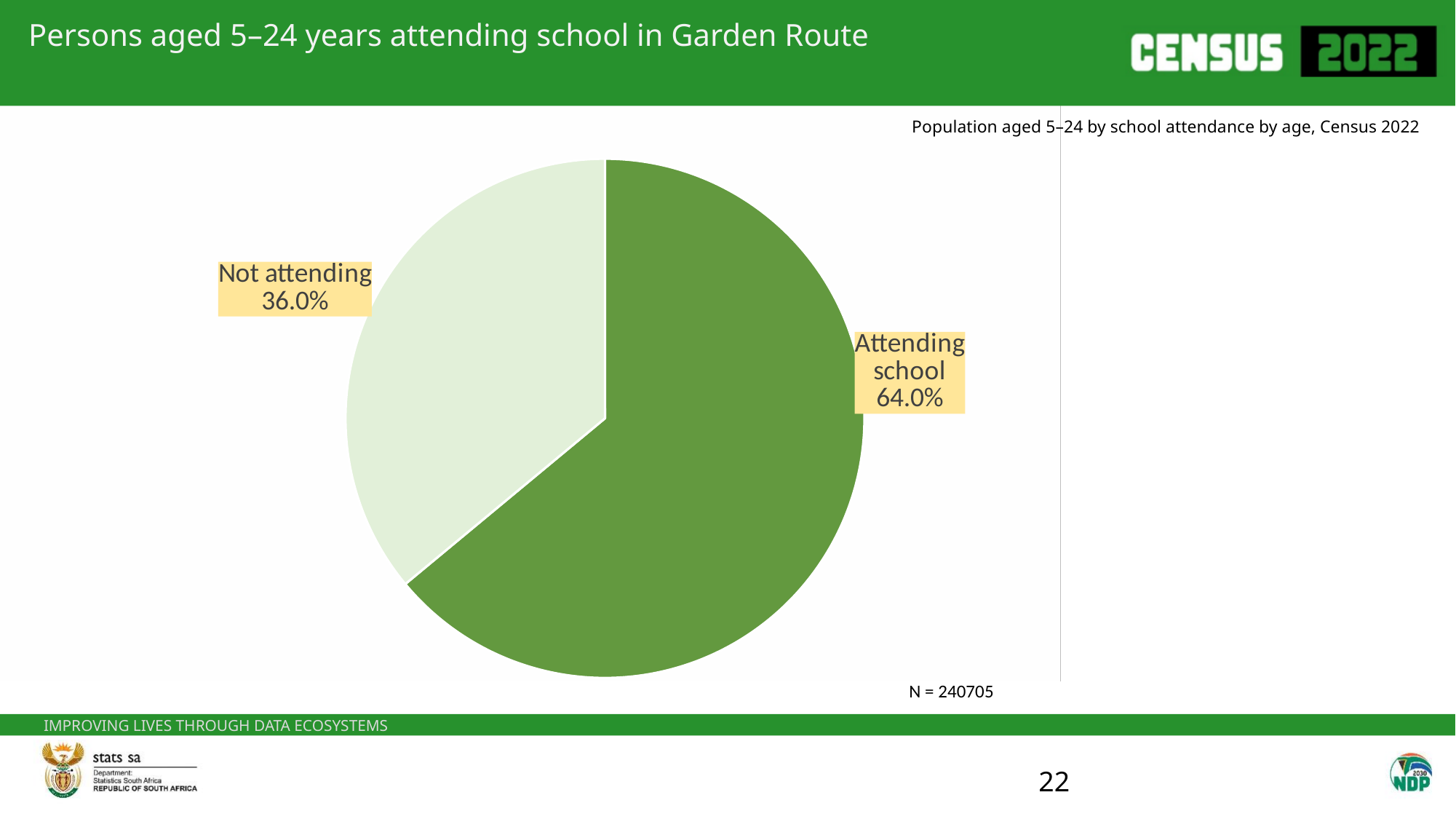
What is the title of the chart on the slide? Population aged 5–24 by school attendance by age, Census 2022 What is the difference in percentage points between the Attending school and Not attending slices? 28.0 percentage points How many slices does the pie chart have? 2 What percentage of persons aged 5–24 in Garden Route are not attending school? 36.0% What is the value of N shown below the chart? N = 240705 Which category has the smaller share of the pie? Not attending Is the share for Attending school larger or smaller than the share for Not attending? Larger What percentage of persons aged 5–24 in Garden Route are attending school? 64.0% What share of the pie does the Not attending slice represent? 36.0% What type of chart is shown on the slide? Pie chart Which category has the larger share of the pie? Attending school